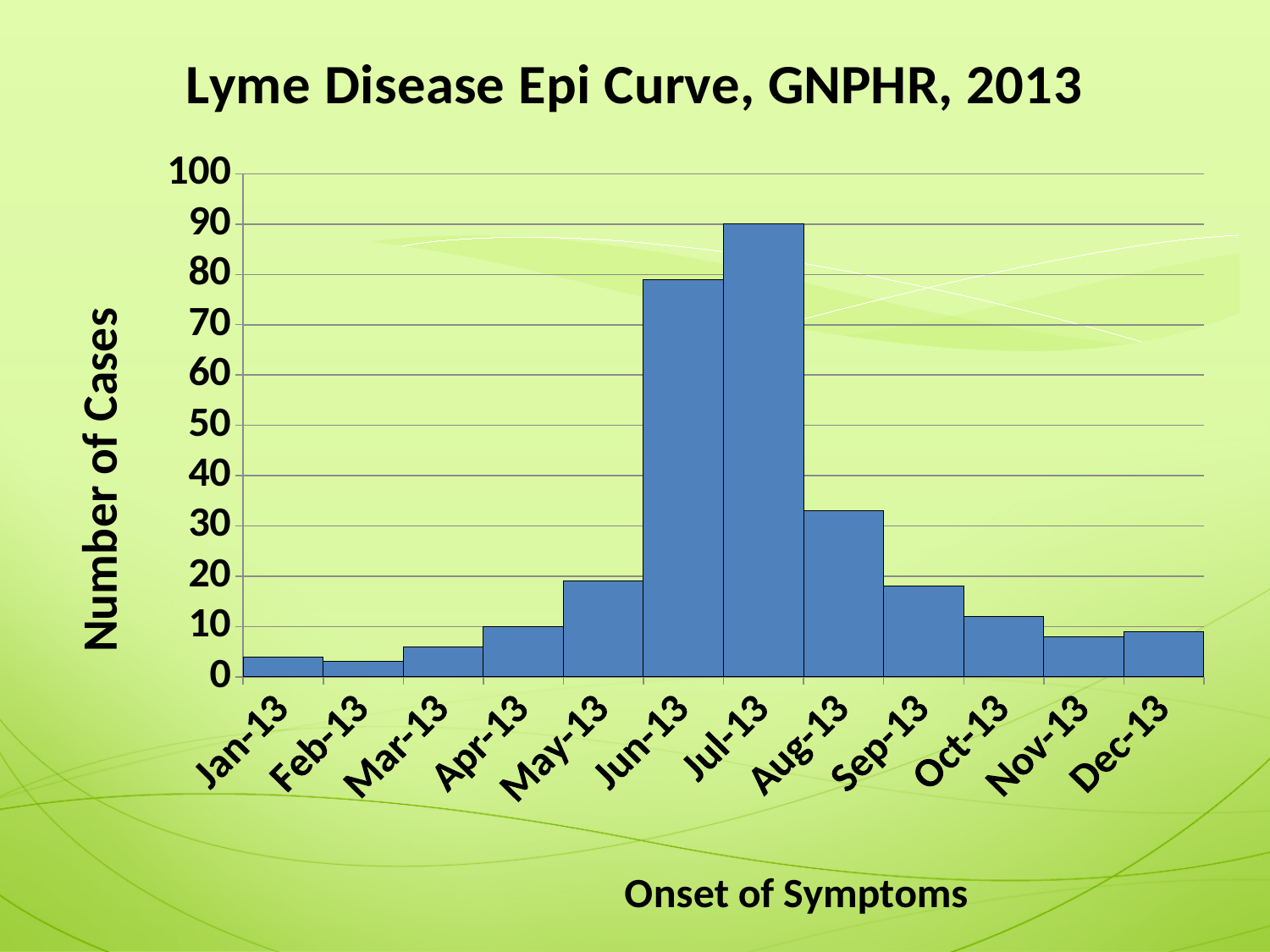
What is the number of cases for Jul-13? 90 Is the number of cases for Sep-13 greater or less than 20? less Is the number of cases for Jun-13 greater or less than 70? greater What is the label of the y axis? Number of Cases What type of chart is shown on the slide? bar chart Is the number of cases for Nov-13 greater or less than 10? less How many months are shown on the x axis of the chart? 12 Which month has more cases, Jun-13 or Aug-13? Jun-13 What is the title of the chart? Lyme Disease Epi Curve, GNPHR, 2013 Which month has the highest number of cases? Jul-13 Do the number of cases rise or fall from Jul-13 to Dec-13? fall